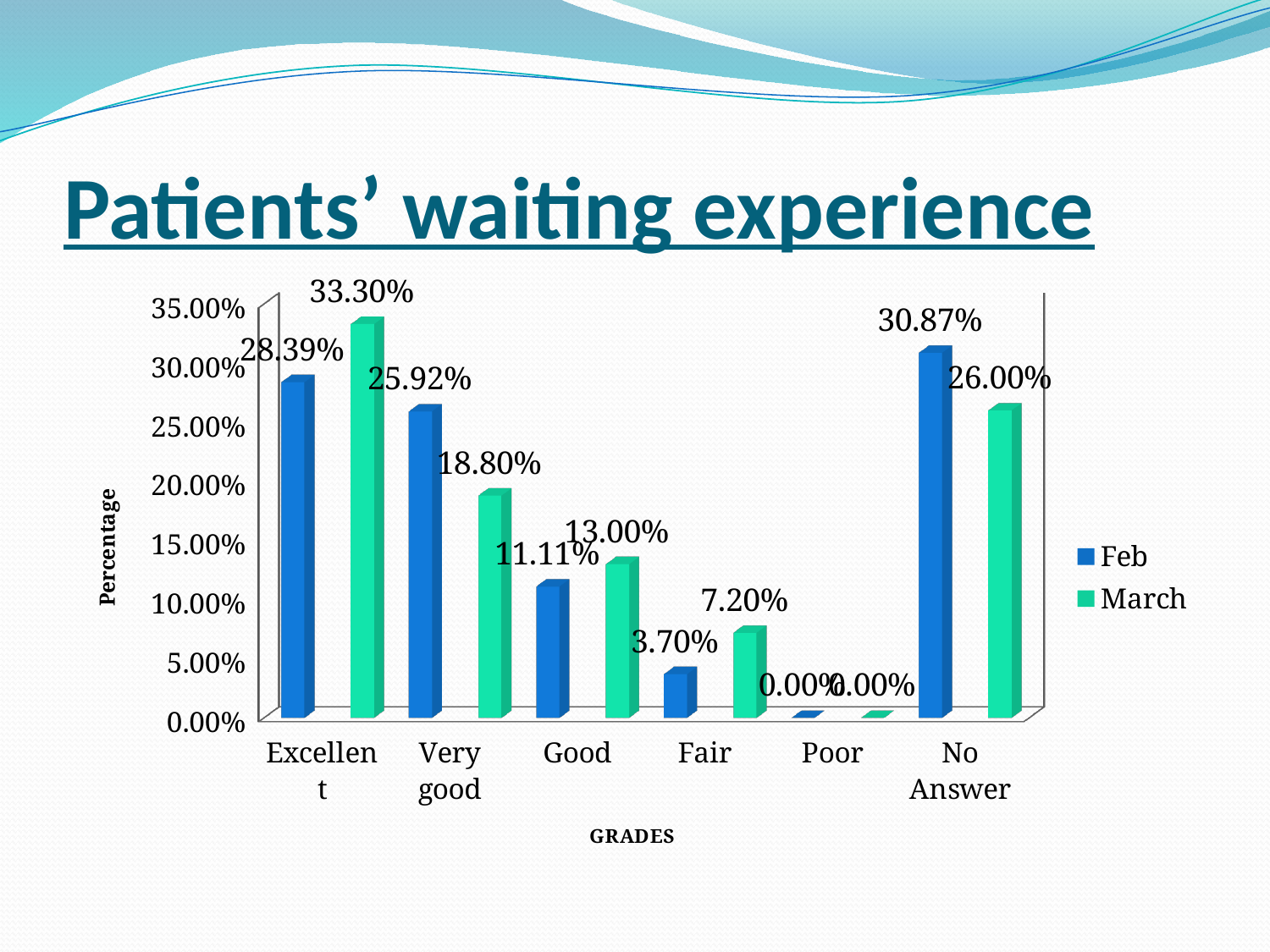
What is the March value for Fair? 7.20% How many grade categories are shown on the x axis? 6 What is the Feb value for Excellent? 28.39% What is the difference between the March and Feb values for Excellent? 4.91% What type of chart is shown on the slide? Bar chart What is the Feb value for No Answer? 30.87% How many series does the legend list? 2 Which grade has the highest March value? Excellent Which is larger for Good, the Feb value or the March value? March What is the March value for Very good? 18.80% Which grade has the highest Feb value? No Answer Which grade has the lowest value for both Feb and March? Poor